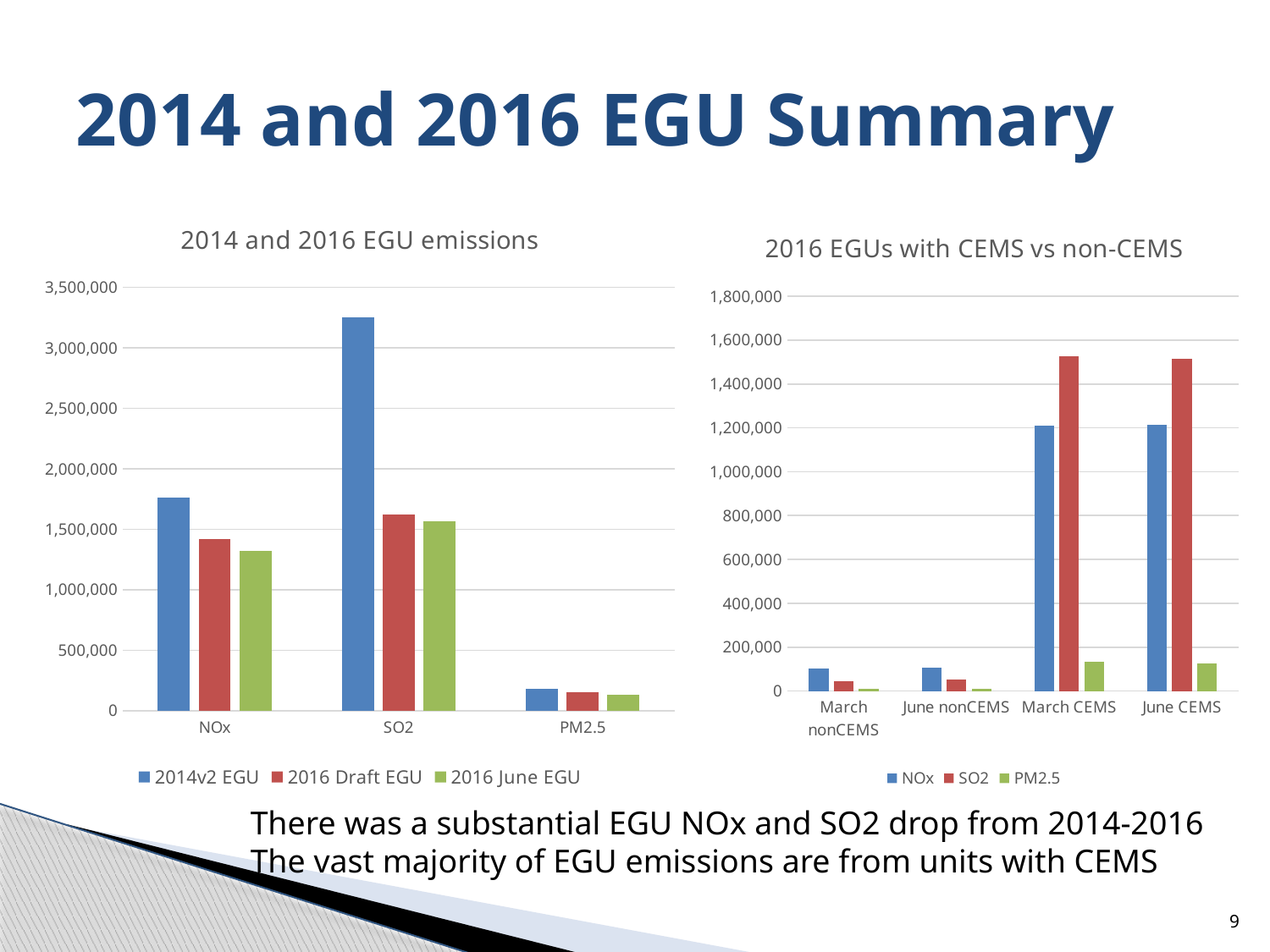
On the left chart titled '2014 and 2016 EGU emissions', is the 2014v2 EGU value for SO2 greater or less than 3,000,000? greater On the left chart titled '2014 and 2016 EGU emissions', which category has the lowest values across all three series? PM2.5 On the left chart titled '2014 and 2016 EGU emissions', how many series does the legend list? 3 On the left chart titled '2014 and 2016 EGU emissions', which category has the highest 2014v2 EGU bar? SO2 On the right chart titled '2016 EGUs with CEMS vs non-CEMS', which series has the highest bar for March CEMS? SO2 On the left chart titled '2014 and 2016 EGU emissions', what kind of chart is shown? bar chart On the right chart titled '2016 EGUs with CEMS vs non-CEMS', is the SO2 value for March CEMS greater or less than 1,400,000? greater On the right chart titled '2016 EGUs with CEMS vs non-CEMS', how many categories are shown on the x axis? 4 On the left chart titled '2014 and 2016 EGU emissions', for NOx, which is larger: the 2014v2 EGU value or the 2016 Draft EGU value? 2014v2 EGU On the left chart titled '2014 and 2016 EGU emissions', how many pollutant categories are shown on the x axis? 3 On the left chart titled '2014 and 2016 EGU emissions', is the 2016 June EGU value for NOx greater or less than 1,500,000? less On the right chart titled '2016 EGUs with CEMS vs non-CEMS', how many series does the legend list? 3